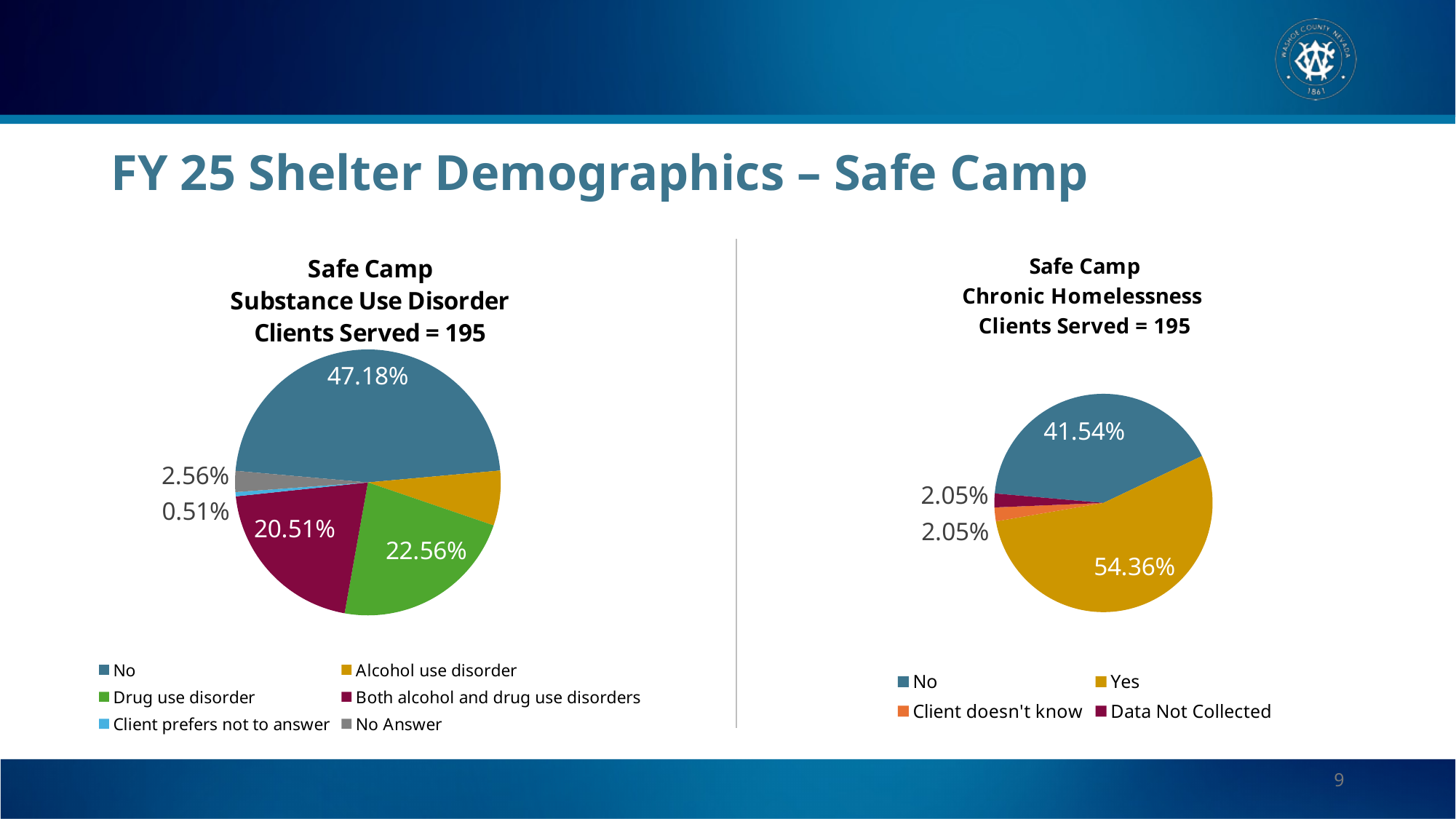
In the Safe Camp Substance Use Disorder pie chart, what percentage is shown for "Both alcohol and drug use disorders"? 20.51% How many categories does the legend of the Safe Camp Chronic Homelessness chart list? 4 In the Safe Camp Chronic Homelessness pie chart, what percentage is shown for "Yes"? 54.36% In the Safe Camp Substance Use Disorder pie chart, what percentage is shown for "Drug use disorder"? 22.56% In the Safe Camp Substance Use Disorder pie chart, which is larger: "Drug use disorder" or "Both alcohol and drug use disorders"? Drug use disorder In the Safe Camp Substance Use Disorder pie chart, which category has the smallest slice? Client prefers not to answer In the Safe Camp Substance Use Disorder pie chart, which category has the largest slice? No How many categories does the legend of the Safe Camp Substance Use Disorder chart list? 6 In the Safe Camp Chronic Homelessness pie chart, what percentage is shown for "No"? 41.54% In the Safe Camp Chronic Homelessness pie chart, what is the difference in percentage points between "Yes" and "No"? 12.82 percentage points What kind of chart is the Safe Camp Chronic Homelessness chart? Pie chart In the Safe Camp Substance Use Disorder pie chart, what percentage of clients is shown for "No"? 47.18%